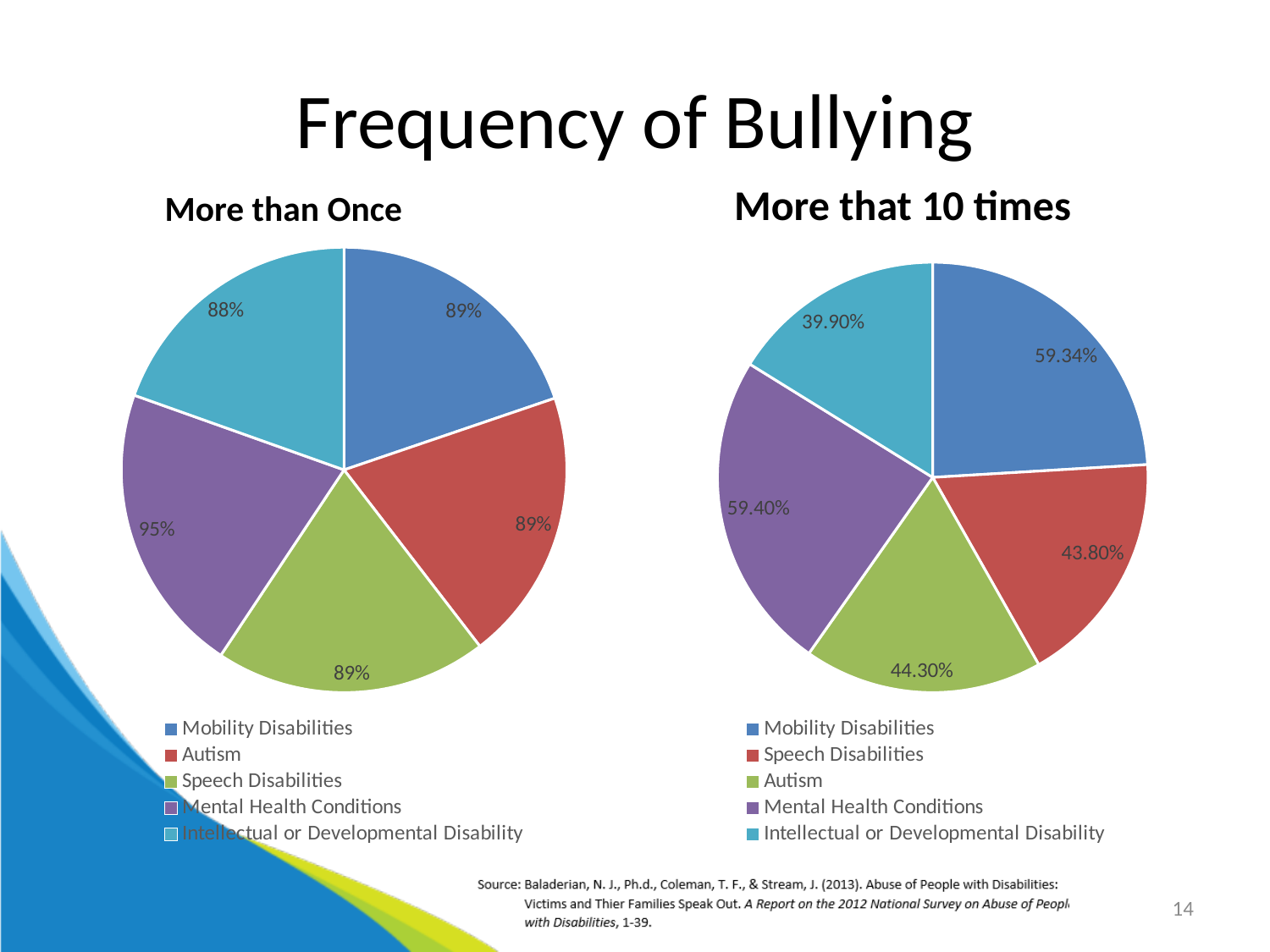
In the 'More that 10 times' chart, what is the value for Mobility Disabilities? 59.34% In the 'More than Once' chart, what is the value for Mental Health Conditions? 95% In the 'More that 10 times' chart, what is the difference between Mobility Disabilities and Speech Disabilities? 15.54% In the 'More than Once' chart, which category has the highest value? Mental Health Conditions In the 'More that 10 times' chart, what is the value for Autism? 44.30% In the 'More than Once' chart, what is the value for Intellectual or Developmental Disability? 88% In the 'More than Once' chart, what is the difference between Mental Health Conditions and Intellectual or Developmental Disability? 7% How many categories does the 'More than Once' chart show? 5 In the 'More that 10 times' chart, which is larger: Mobility Disabilities or Speech Disabilities? Mobility Disabilities In the 'More that 10 times' chart, which category is shown in green? Autism What kind of chart is used for 'More than Once'? pie chart In the 'More that 10 times' chart, which category has the lowest value? Intellectual or Developmental Disability